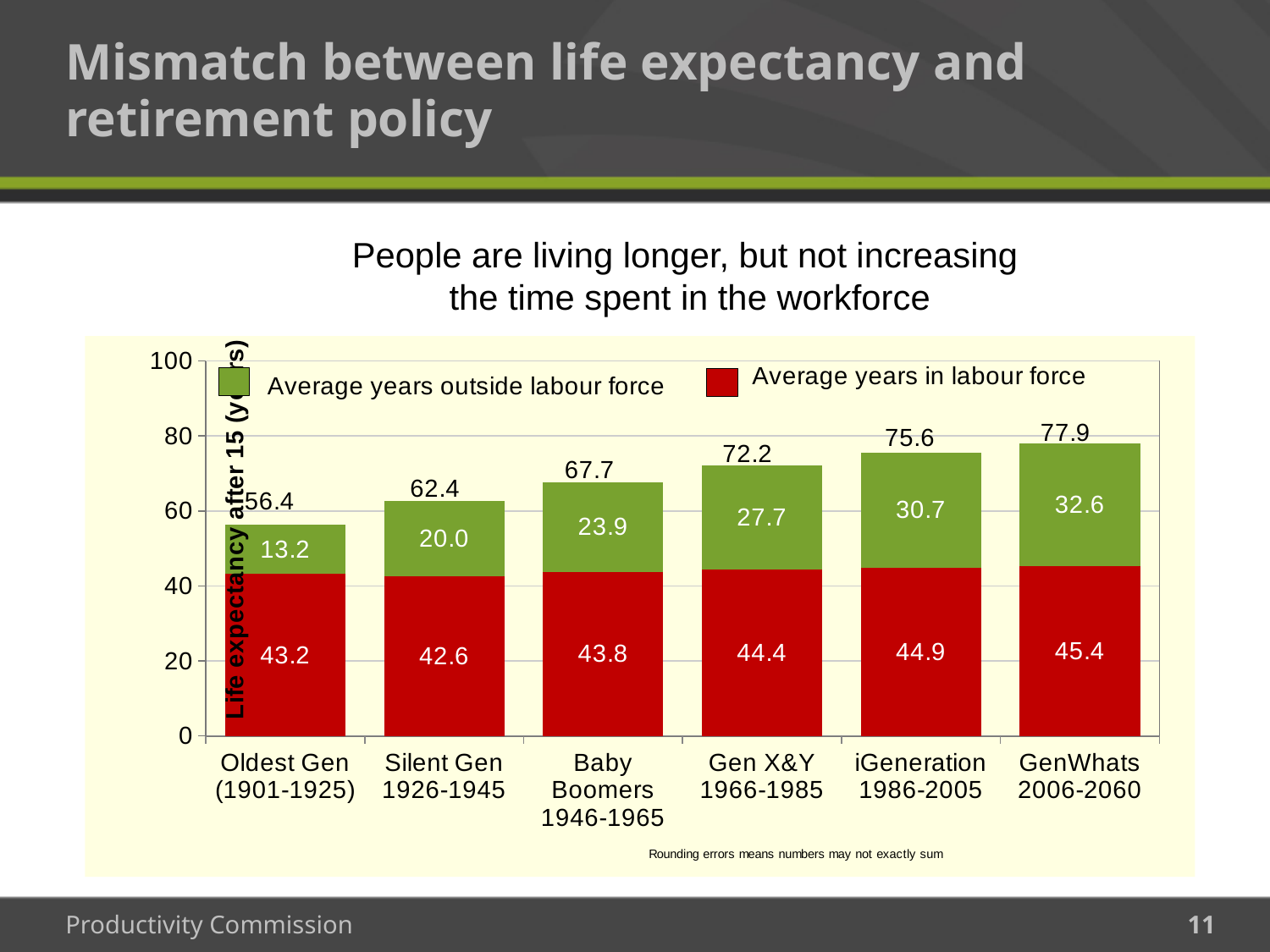
What is the difference in average years outside labour force between iGeneration 1986-2005 and Oldest Gen (1901-1925)? 17.5 Which generation has the highest average years outside labour force? GenWhats 2006-2060 Which generation has the lowest average years in labour force? Silent Gen 1926-1945 What kind of chart is shown on the slide? Stacked bar chart Do the total life expectancy values rise or fall moving from Oldest Gen to GenWhats along the x axis? Rise What is the total life expectancy after 15 shown for GenWhats 2006-2060? 77.9 How many generation categories are shown along the x axis? 6 Which is larger: average years in labour force for Gen X&Y 1966-1985 or for Silent Gen 1926-1945? Gen X&Y 1966-1985 What is the average years outside labour force for Gen X&Y 1966-1985? 27.7 What is the average years in labour force for Baby Boomers 1946-1965? 43.8 How many series does the legend list? 2 Which colour represents average years in labour force in the legend? Red